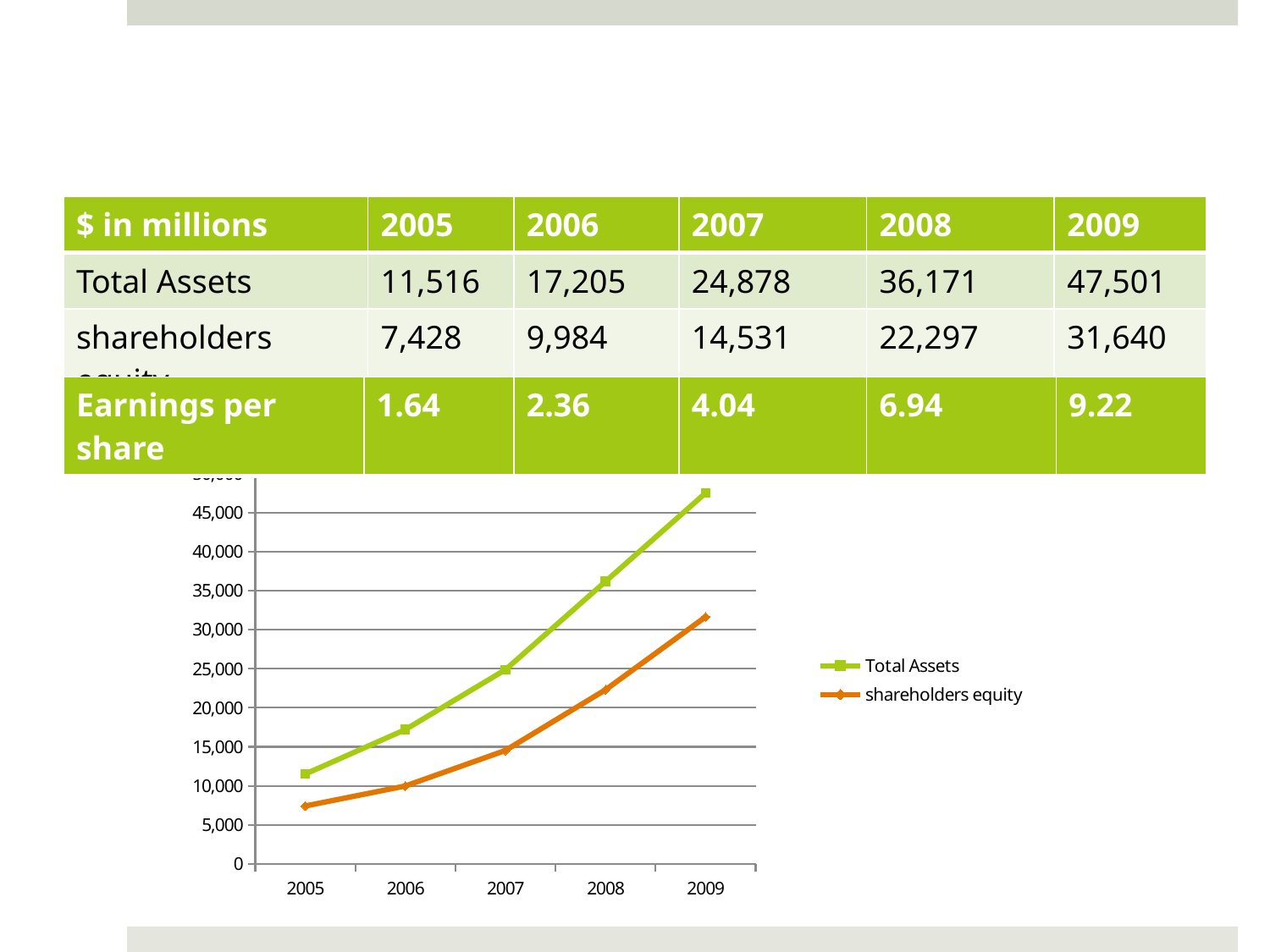
What kind of chart is shown on the slide? line chart Is the value for Total Assets in 2009 greater or less than 45,000? greater What is the value of Total Assets in 2008 according to the slide? 36,171 Do Total Assets rise or fall from 2005 to 2009? rise Does shareholders equity rise or fall across the years shown? rise What colour is the Total Assets line in the chart? green How many years are plotted along the x axis of the chart? 5 Which series is higher in 2009, Total Assets or shareholders equity? Total Assets Is the value for shareholders equity in 2007 greater or less than 15,000? less How many series does the chart legend list? 2 In which year is shareholders equity lowest? 2005 In which year are Total Assets highest? 2009